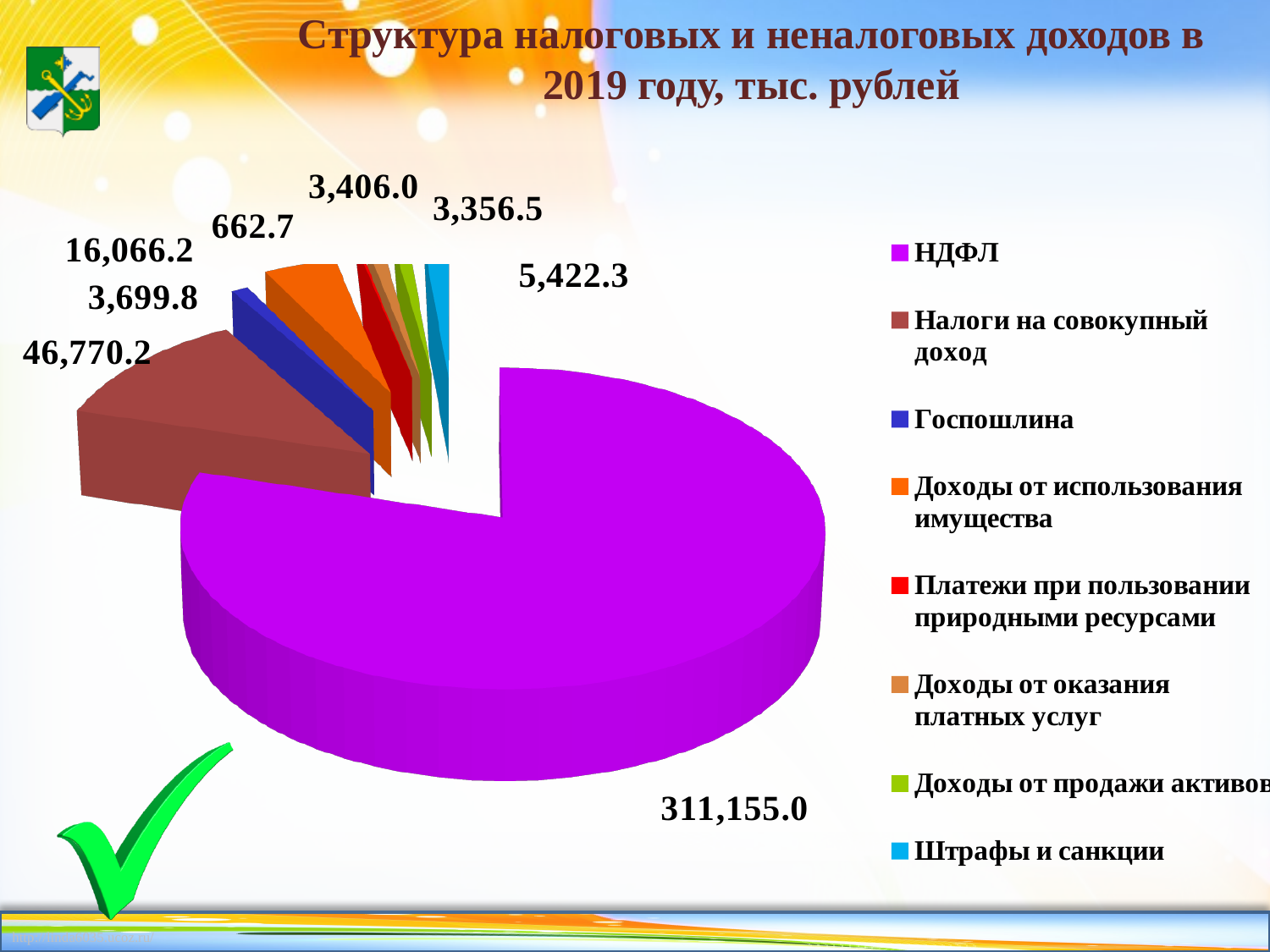
Which colour represents Штрафы и санкции in the legend? Light blue What kind of chart is shown on the slide? Pie chart Which category has the largest slice of the pie? НДФЛ Which is larger, НДФЛ or Налоги на совокупный доход? НДФЛ What is the total of all values shown on the pie chart? 390,538.7 What is the title of the chart? Структура налоговых и неналоговых доходов в 2019 году, тыс. рублей What is the value for НДФЛ? 311,155.0 How many categories does the pie chart show? 8 What is the value for Налоги на совокупный доход? 46,770.2 What is the value for Доходы от использования имущества? 16,066.2 What is the difference between the values for НДФЛ and Налоги на совокупный доход? 264,384.8 What is the smallest value shown on the pie chart? 662.7